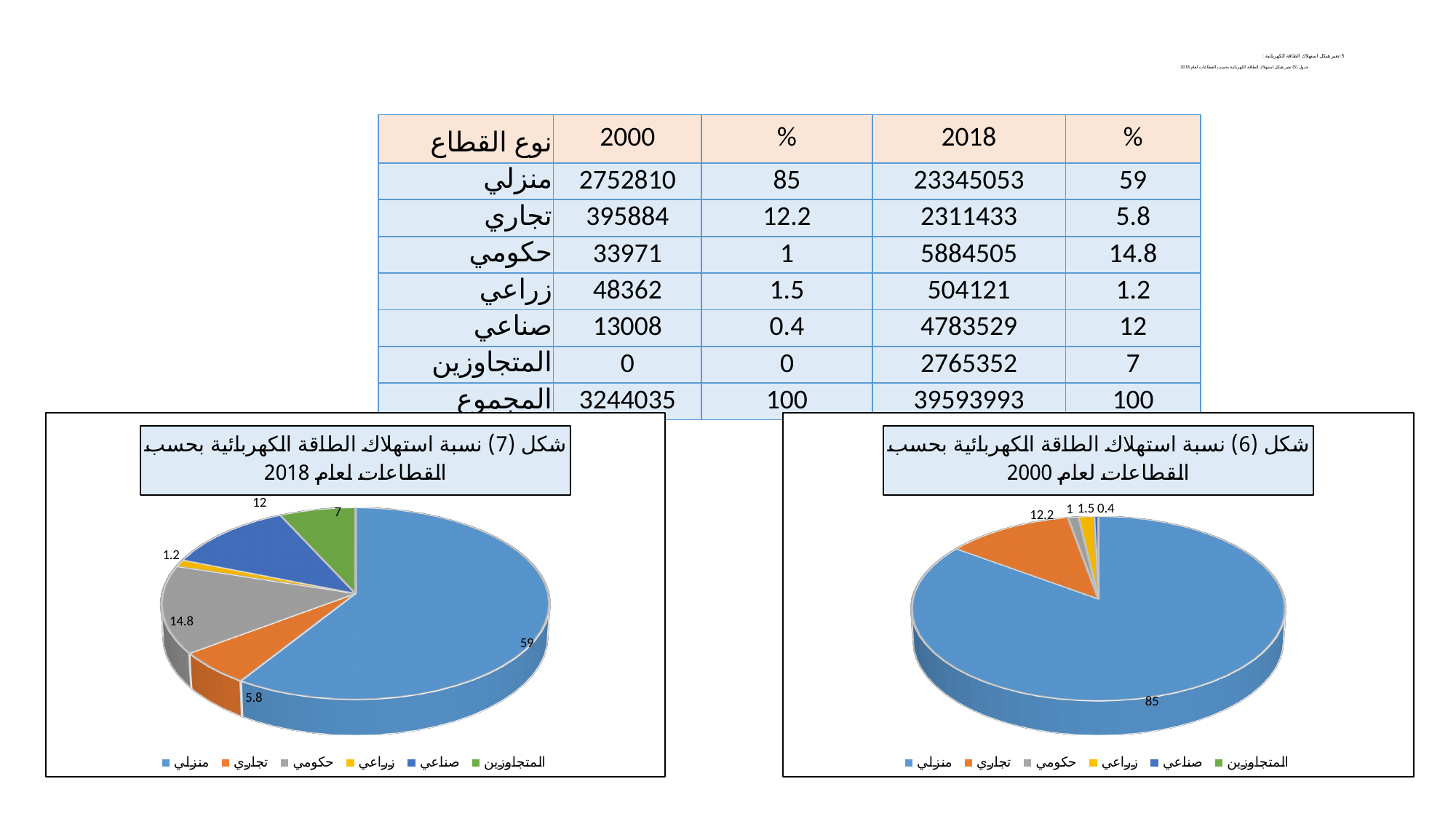
In the right chart (شكل (6), year 2000), what is the difference between the تجاري value and the زراعي value? 10.7 In the right chart (شكل (6), year 2000), what is the value shown for the تجاري slice? 12.2 In the right chart (شكل (6), year 2000), which labelled sector has the smallest slice? صناعي What colour is the منزلي slice in the left chart (شكل (7), year 2018)? Blue How many series does the legend of the right chart (شكل (6), year 2000) list? 6 In the left chart (شكل (7), year 2018), which sector has the largest slice? منزلي In the left chart (شكل (7), year 2018), what is the value shown for the حكومي slice? 14.8 In the left chart (شكل (7), year 2018), what is the value shown for the المتجاوزين slice? 7 In the right chart (شكل (6), year 2000), what is the value shown for the منزلي slice? 85 What type of chart is the left chart titled "شكل (7) نسبة استهلاك الطاقة الكهربائية بحسب القطاعات لعام 2018"? Pie chart In the left chart (شكل (7), year 2018), which is larger, the صناعي slice or the تجاري slice? صناعي In the left chart (شكل (7), year 2018), what is the difference between the منزلي value and the حكومي value? 44.2